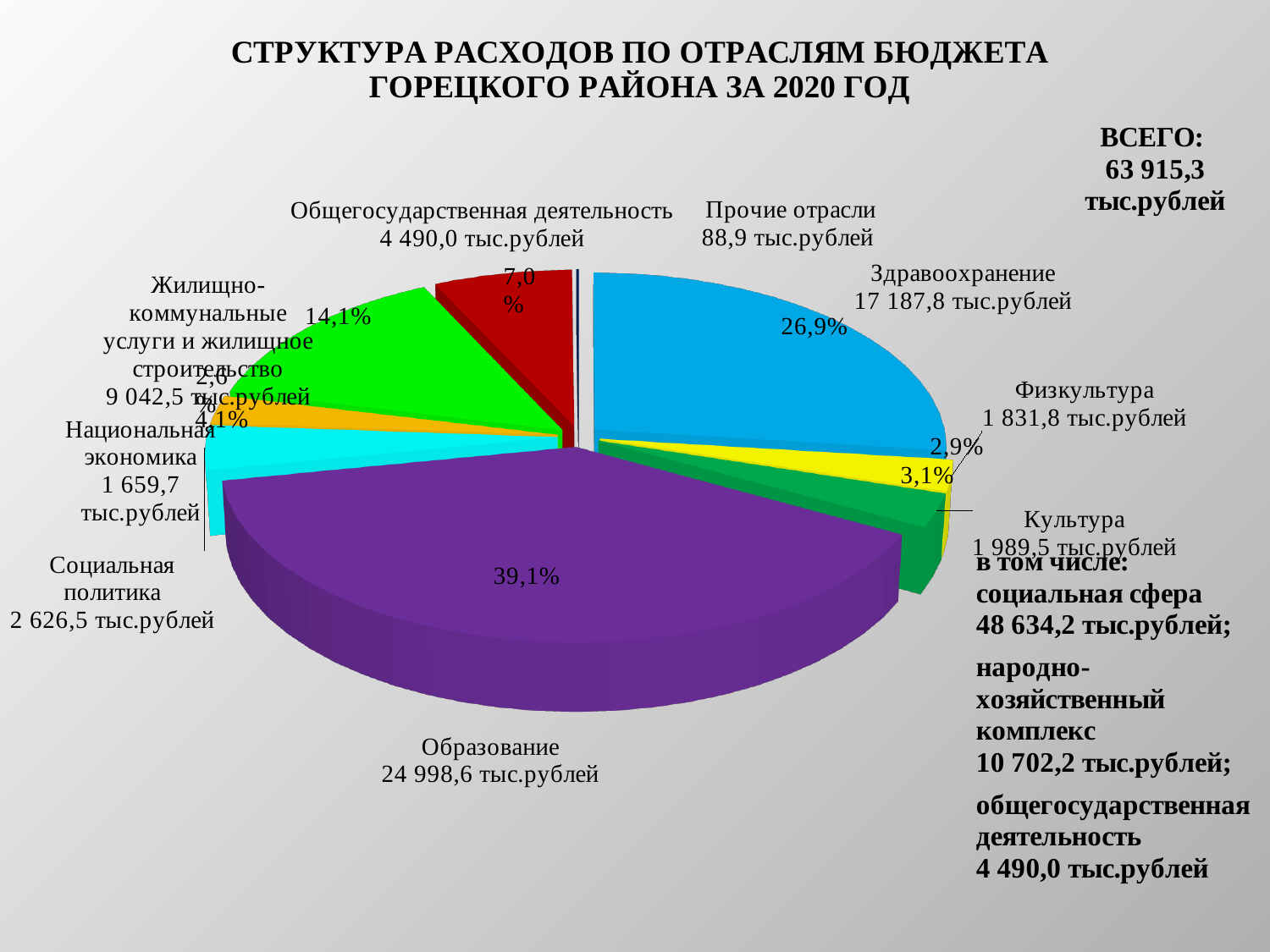
How many sectors are shown in the pie chart? 9 What is the difference between the expenditure for Образование and for Здравоохранение? 7 810,8 тыс.рублей Which sector has the smallest slice of the pie? Прочие отрасли What share of the pie does Здравоохранение take? 26,9% Which sector has the largest slice of the pie? Образование What is the expenditure amount for Здравоохранение? 17 187,8 тыс.рублей What share of the pie does Образование take? 39,1% What type of chart is shown on the slide? pie chart What is the expenditure amount for Физкультура? 1 831,8 тыс.рублей Which is larger: the expenditure for Культура or for Физкультура? Культура What total expenditure (ВСЕГО) is stated on the slide? 63 915,3 тыс.рублей What is the expenditure amount for Образование? 24 998,6 тыс.рублей